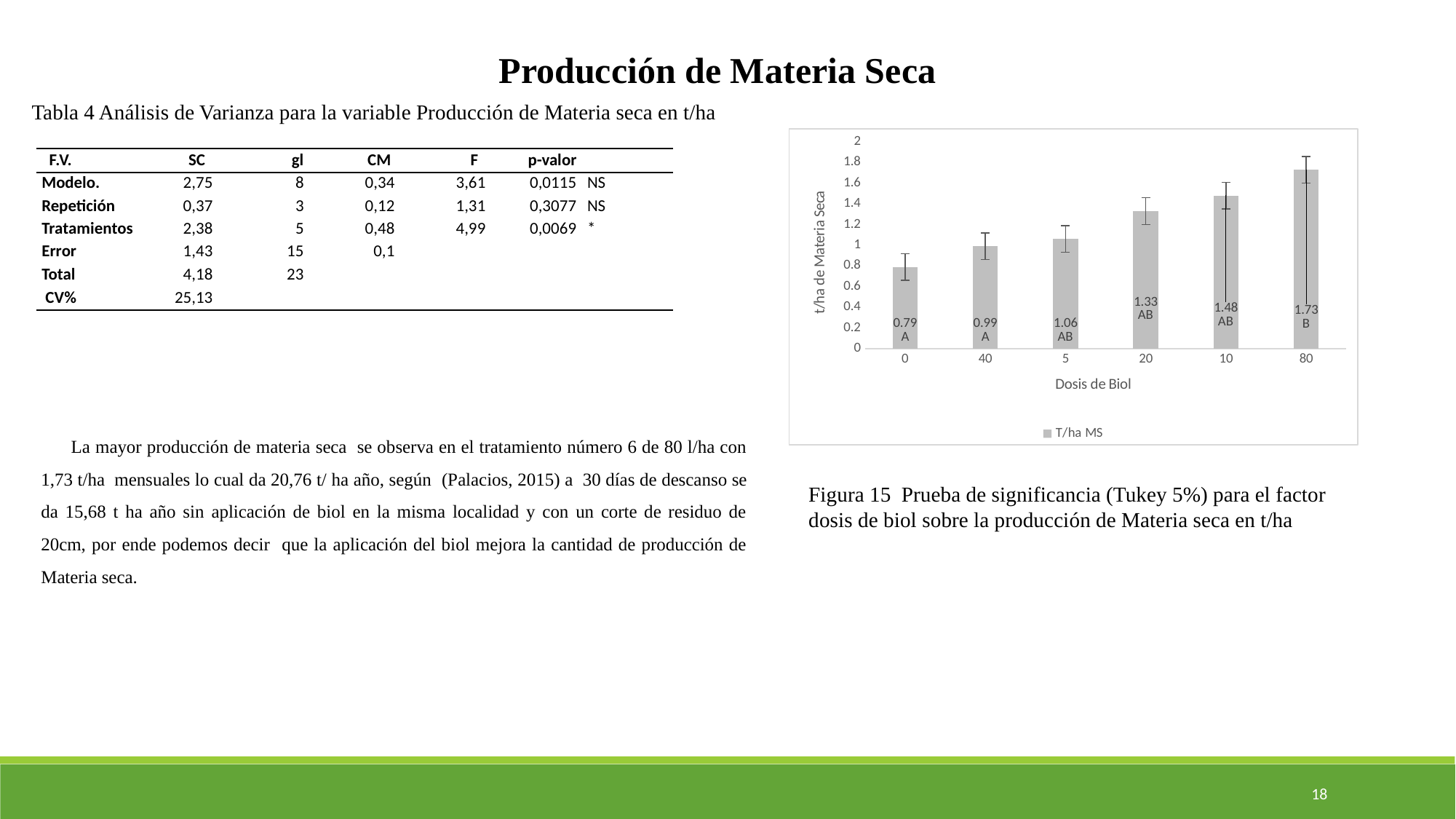
What is the value for dosis de biol 0 in the chart? 0.79 Which dosis de biol has the lowest value in the chart? 0 What kind of chart is shown on the slide? Bar chart What is the value for dosis de biol 80 in the chart? 1.73 Which dosis de biol has the highest value in the chart? 80 What is the difference between the values for dosis 80 and dosis 0? 0.94 What is the value for dosis de biol 20 in the chart? 1.33 Which has a larger value, dosis 40 or dosis 5? 5 Is the value for dosis 10 greater or less than 1.2? greater What is the series name shown in the chart legend? T/ha MS How many dosis de biol categories are shown on the x axis? 6 What is the difference between the values for dosis 10 and dosis 20? 0.15